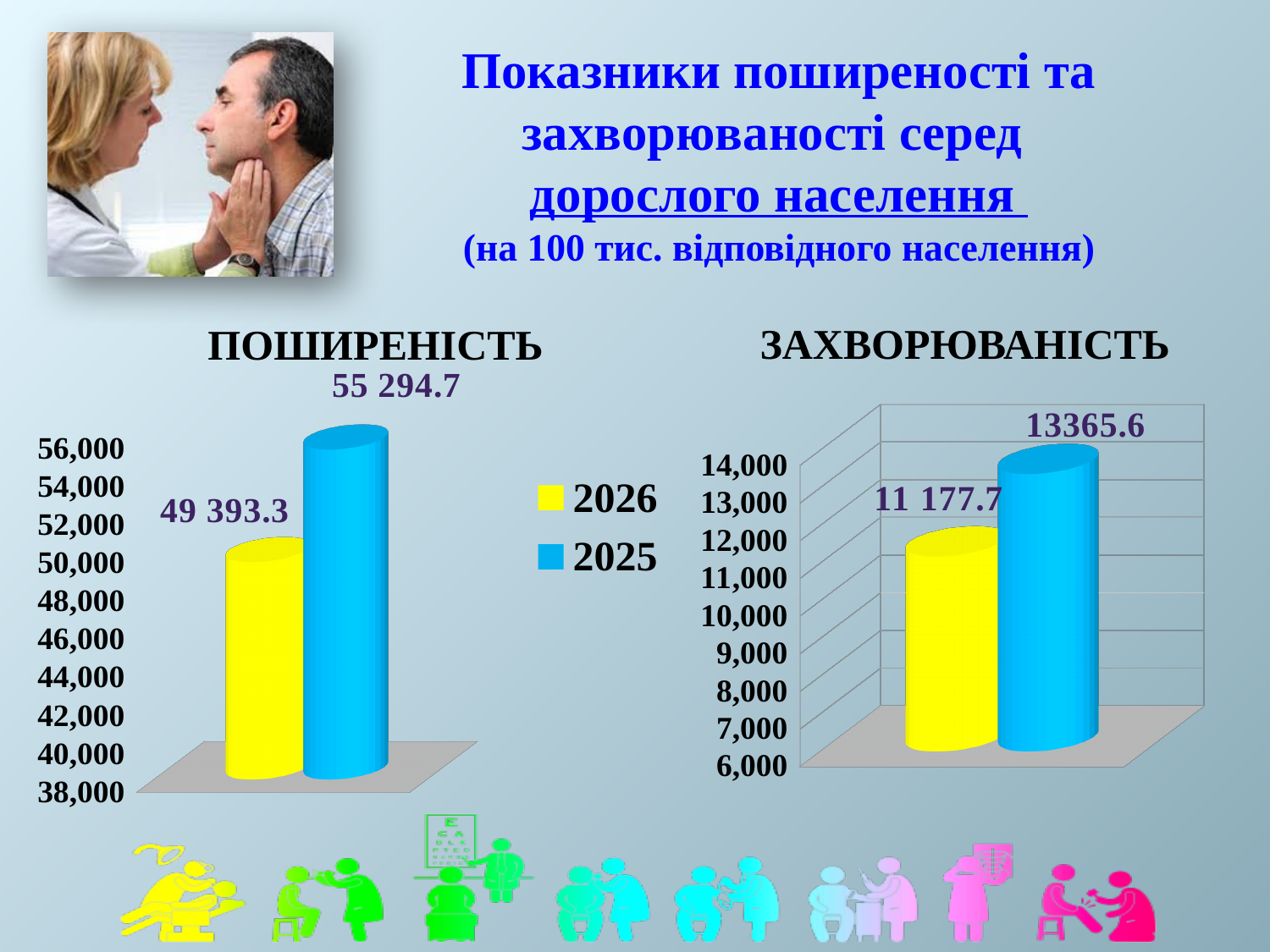
In the ЗАХВОРЮВАНІСТЬ chart, what is the difference between the 2025 and 2026 values? 2187.9 In the ПОШИРЕНІСТЬ chart, what is the value for 2025? 55 294.7 In the ПОШИРЕНІСТЬ chart, which year has the higher value? 2025 In the ПОШИРЕНІСТЬ chart, what is the value for 2026? 49 393.3 What kind of chart is the ПОШИРЕНІСТЬ chart? Bar chart In the ПОШИРЕНІСТЬ chart, what is the difference between the 2025 and 2026 values? 5 901.4 In the ЗАХВОРЮВАНІСТЬ chart, what is the value for 2025? 13365.6 How many series does the legend list? 2 In the ЗАХВОРЮВАНІСТЬ chart, is the value for 2026 greater or less than 12,000? less In the legend, which colour represents 2025? Blue In the ЗАХВОРЮВАНІСТЬ chart, which year has the lower value? 2026 In the ЗАХВОРЮВАНІСТЬ chart, what is the value for 2026? 11 177.7